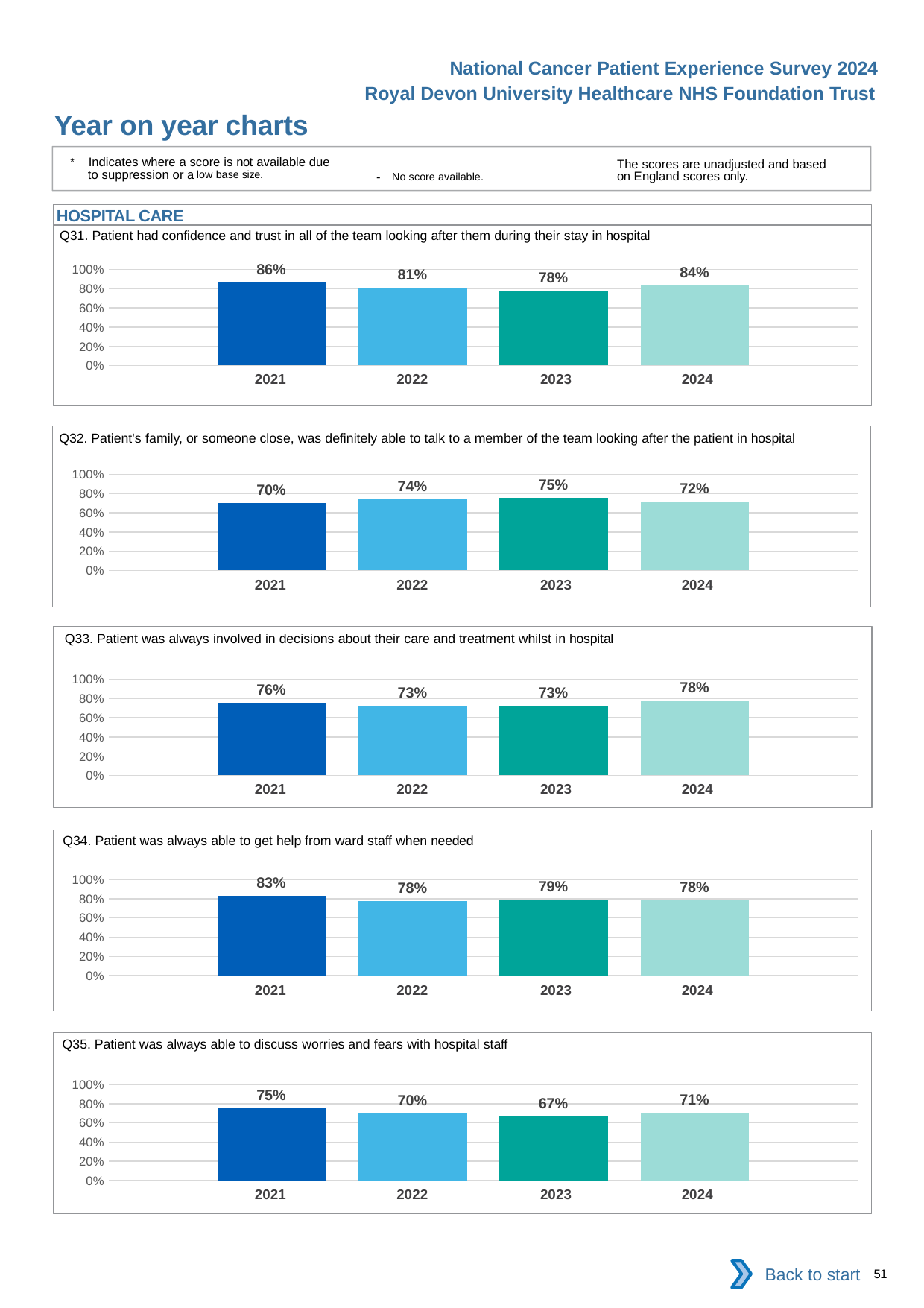
In the Q34 chart (patient was always able to get help from ward staff), what is the value for 2023? 79% In the Q32 chart (patient's family was definitely able to talk to a member of the team), what is the value for 2024? 72% In the Q34 chart, what is the difference between the 2021 and 2022 values? 5% In the Q33 chart (patient was always involved in decisions about their care), what is the difference between the 2024 and 2021 values? 2% In the Q33 chart, which is larger, the value for 2021 or the value for 2024? 2024 In the Q35 chart (patient was always able to discuss worries and fears), which year has the lowest value? 2023 In the Q35 chart, is the value for 2021 greater or less than 60%? greater In the Q32 chart, which year has the highest value? 2023 What kind of chart is the Q34 chart? bar chart In the Q31 chart (patient had confidence and trust in all of the team), what is the value for 2021? 86% In the Q31 chart, which year has the lowest value? 2023 How many years are shown on the x axis of the Q31 chart? 4